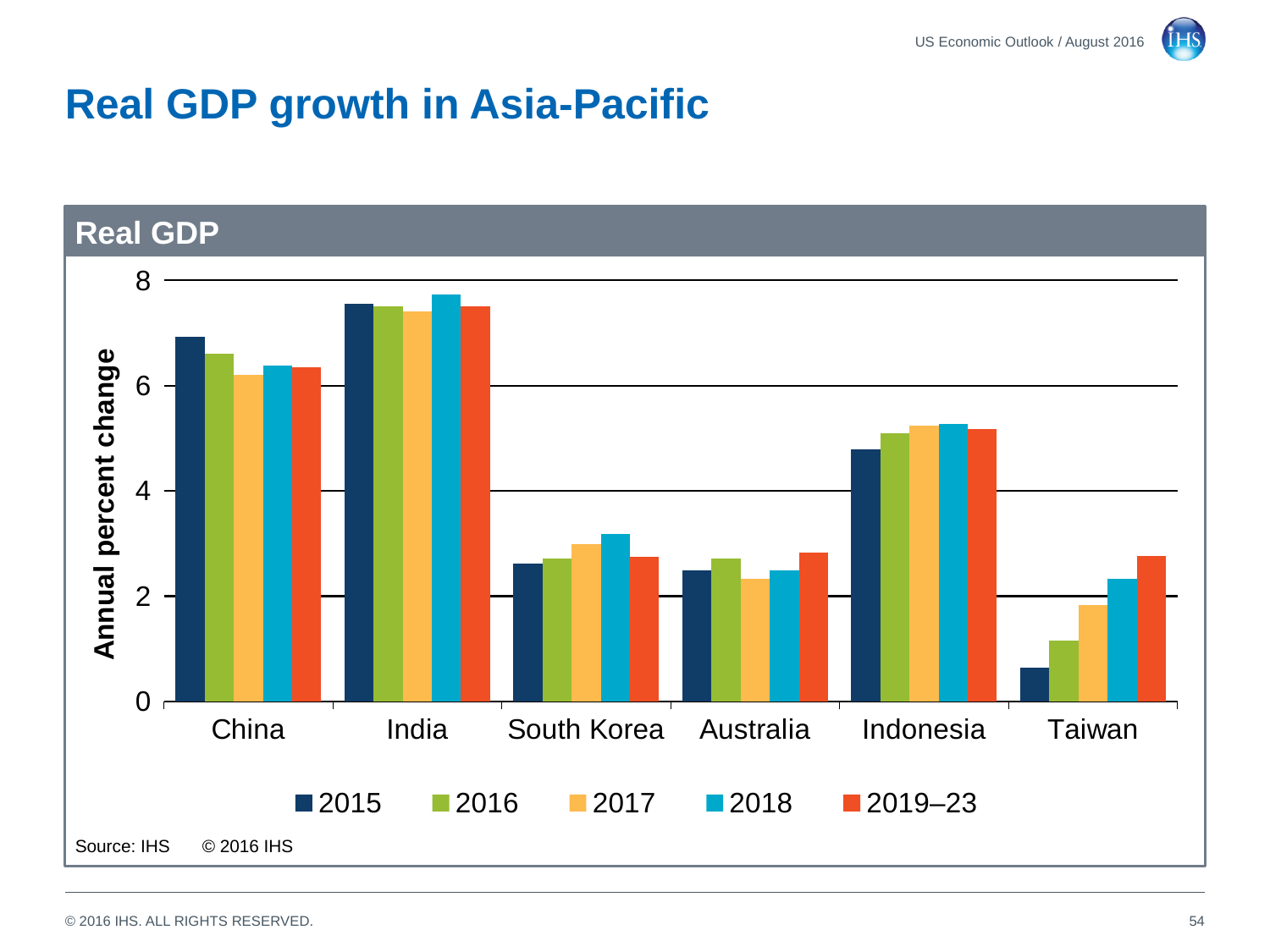
How many series does the legend list? 5 Which country has the lowest real GDP growth in 2015? Taiwan Is the 2016 value for Indonesia greater or less than 4? greater Is the 2015 value for Taiwan greater or less than 2? less How many countries are shown on the x axis of the chart? 6 What is the label of the y axis? Annual percent change What is the title shown in the chart's header bar? Real GDP Which country has the highest real GDP growth in 2015? India Which is larger, the 2015 value for China or the 2015 value for Indonesia? China What kind of chart is shown on the slide? bar chart Is the 2018 value for India greater or less than 6? greater Do the values for Taiwan rise or fall from 2015 through 2019–23? rise